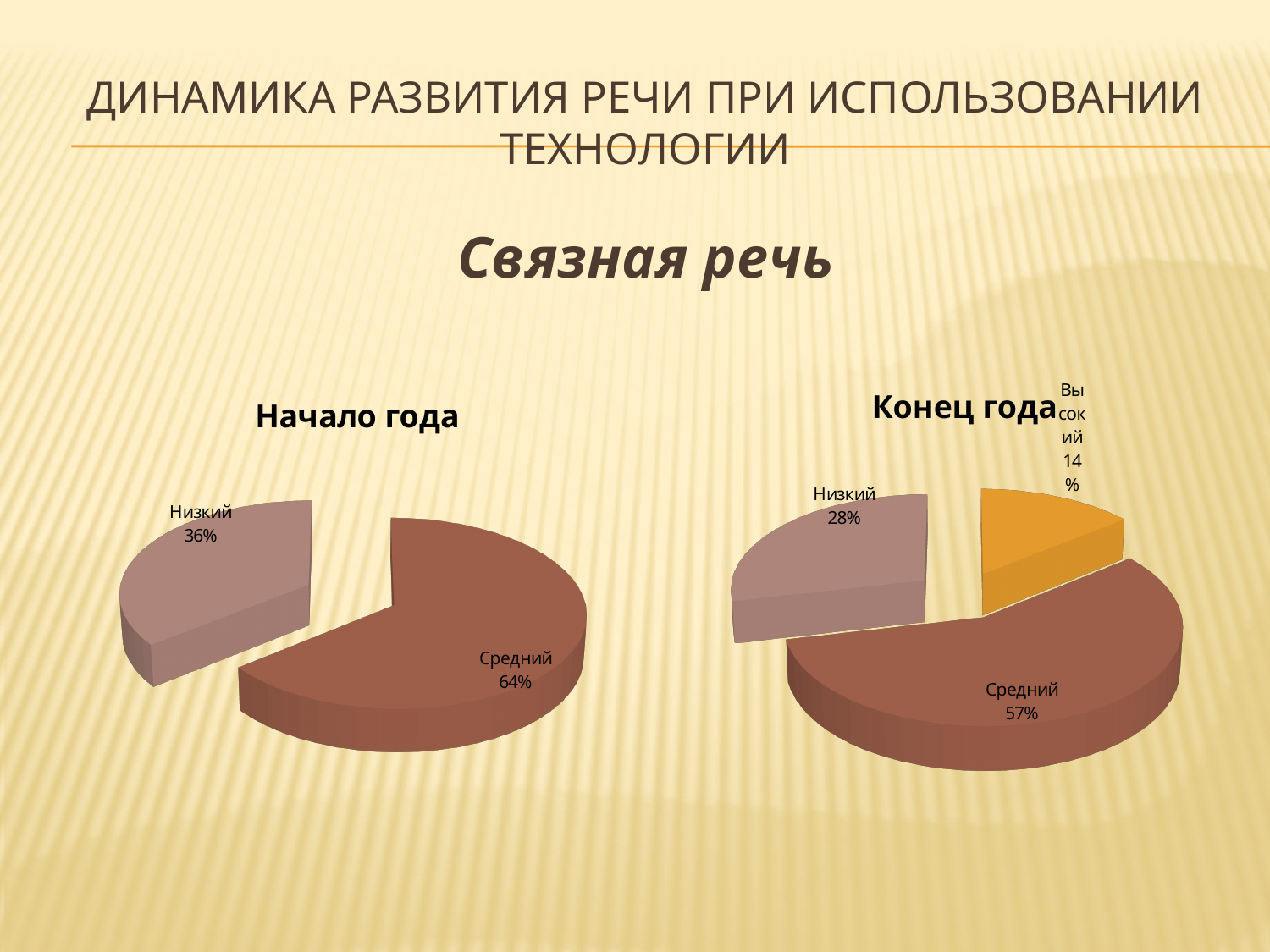
In the 'Конец года' chart, which category has the smallest slice? Высокий In the 'Начало года' chart, what is the difference between the 'Средний' and 'Низкий' shares? 28% In the 'Конец года' chart, what share does 'Высокий' have? 14% In the 'Начало года' chart, what share does 'Низкий' have? 36% In the 'Конец года' chart, what share does 'Низкий' have? 28% In the 'Конец года' chart, which category has the largest slice? Средний How many slices does the 'Начало года' chart have? 2 In the 'Начало года' chart, what share does 'Средний' have? 64% In the 'Конец года' chart, what share does 'Средний' have? 57% What type of chart is the 'Начало года' chart? Pie chart How many slices does the 'Конец года' chart have? 3 In the 'Начало года' chart, which category has the larger slice? Средний